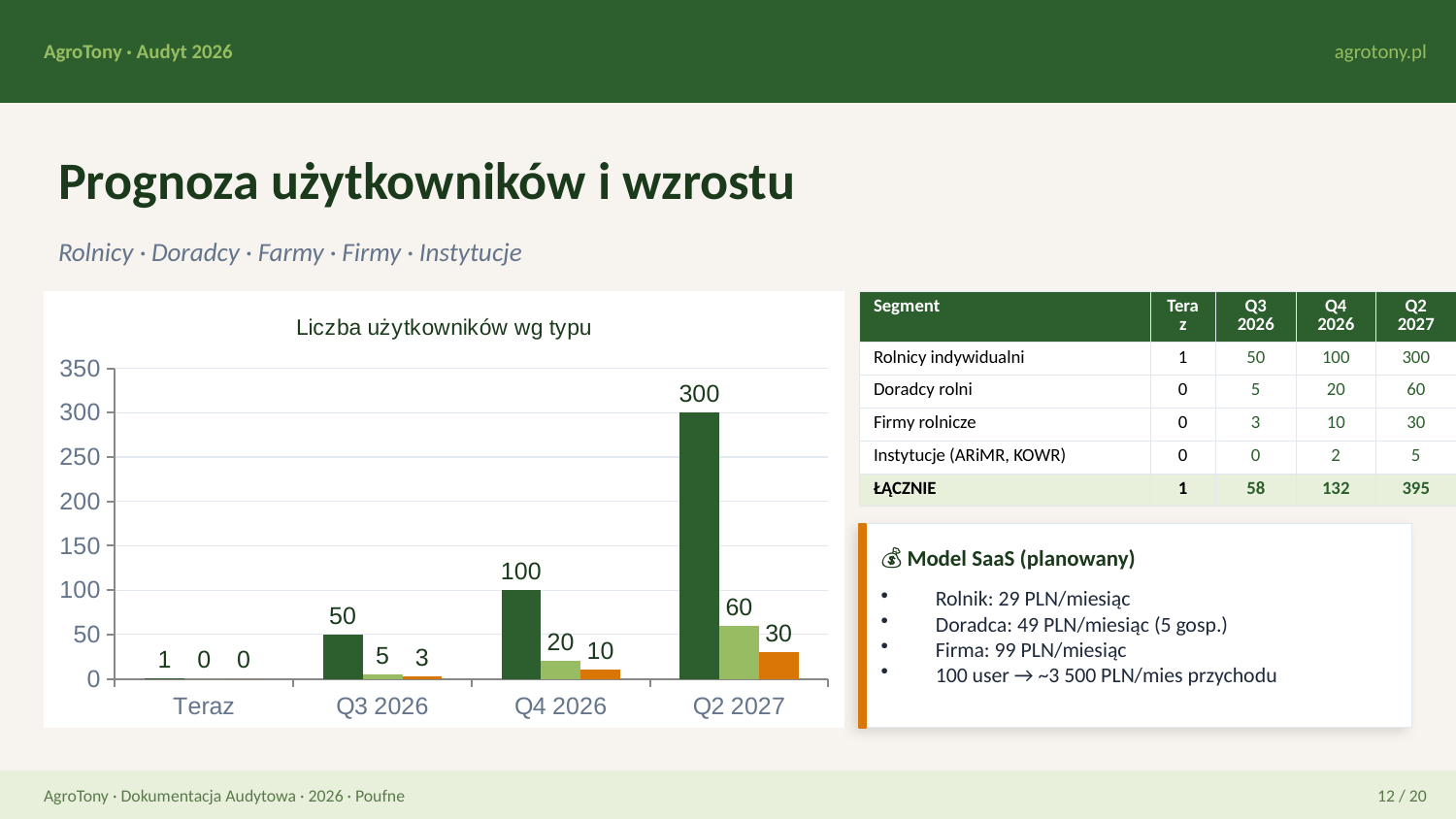
What is the difference between the dark green bar for Q2 2027 and the dark green bar for Q4 2026? 200 What is the value of the dark green bar for Q2 2027? 300 What is the value of the light green bar for Q4 2026? 20 How many categories are shown on the x axis of the chart? 4 Do the dark green bars rise or fall from Teraz to Q2 2027? rise How many bars are plotted for each category in the chart? 3 For Q2 2027, which is larger: the light green bar or the orange bar? light green bar What is the value of the dark green bar for Teraz? 1 What is the value of the orange bar for Q3 2026? 3 What kind of chart is shown on the slide? bar chart Which category has the highest dark green bar? Q2 2027 What is the title of the chart? Liczba użytkowników wg typu